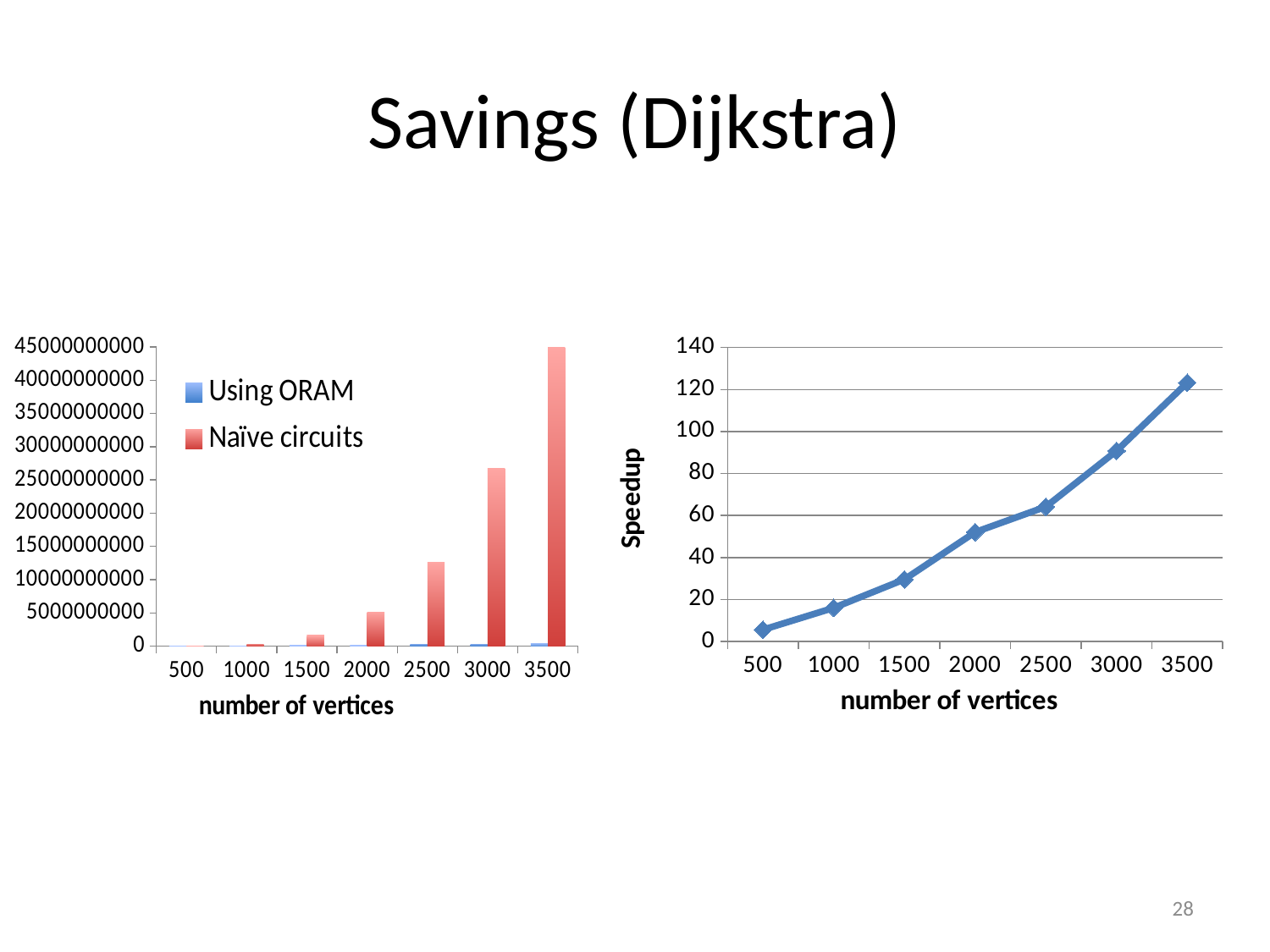
In the left chart, is the Naïve circuits value for 1500 vertices greater or less than 5000000000? less In the right chart, is the Speedup for 1000 vertices greater or less than 20? less What kind of chart is the left chart on the slide? bar chart In the right chart, is the Speedup for 3000 vertices greater or less than 80? greater In the right chart, does the Speedup rise or fall as the number of vertices increases? rise How many data points are plotted on the right chart (Speedup)? 7 How many series does the legend of the left chart list? 2 What kind of chart is the right chart (Speedup) on the slide? line chart In the left chart, which number of vertices has the highest Naïve circuits value? 3500 How many categories (numbers of vertices) are shown on the x axis of the left chart? 7 In the left chart, which series is larger at 2500 vertices, Using ORAM or Naïve circuits? Naïve circuits